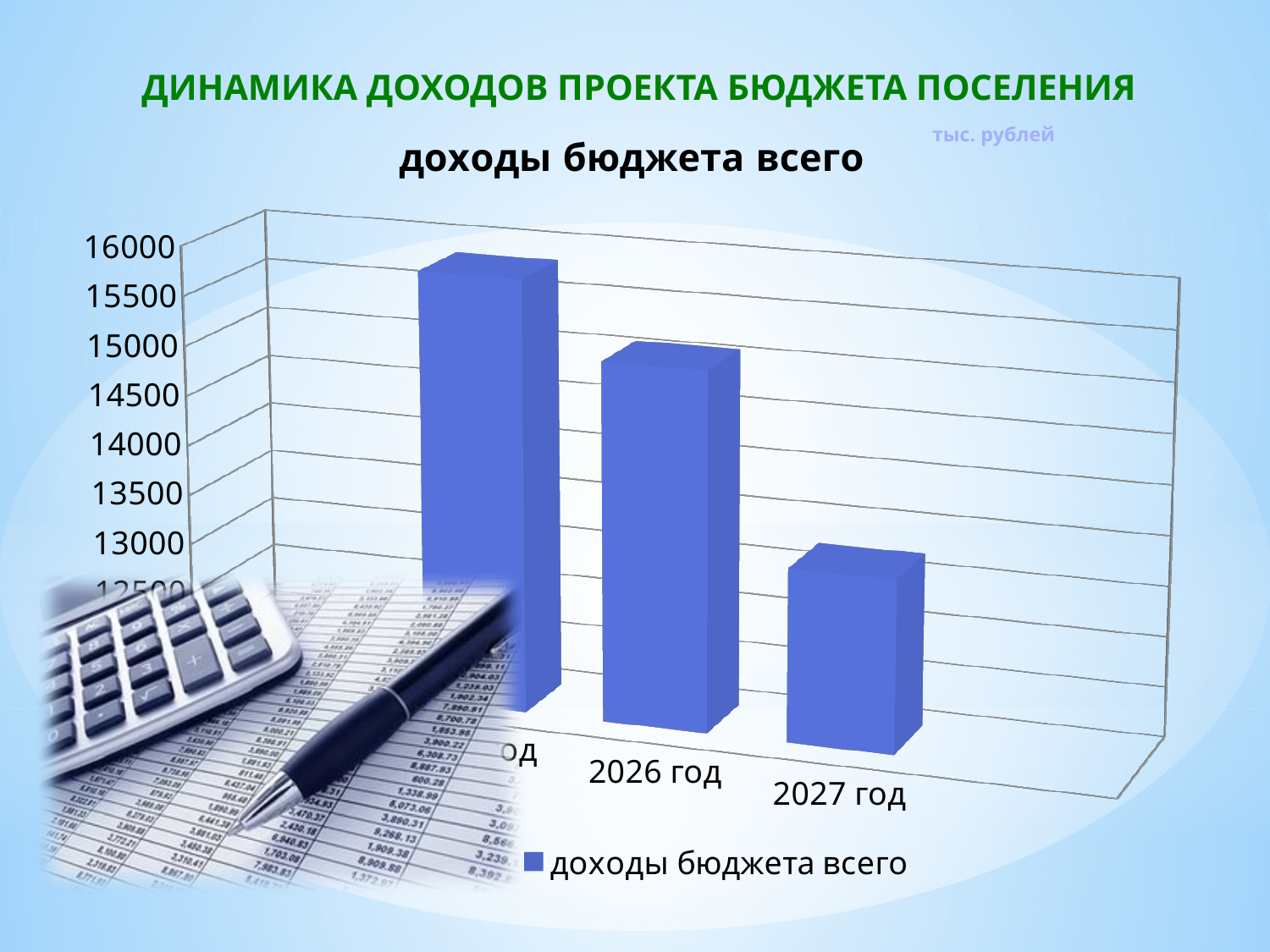
What is the name of the series shown in the legend? доходы бюджета всего Is the value for 2026 год greater or less than 15500? less What kind of chart is shown on the slide? bar chart How many bars (categories) does the chart show? 3 Is the value for 2027 год greater or less than 14000? less Which is larger, the value for 2026 год or the value for 2027 год? 2026 год Which category has the lowest value? 2027 год Do the values rise or fall from left to right along the x axis? fall How many series does the chart legend list? 1 Is the value for 2026 год greater or less than 14000? greater What is the title of the chart? доходы бюджета всего